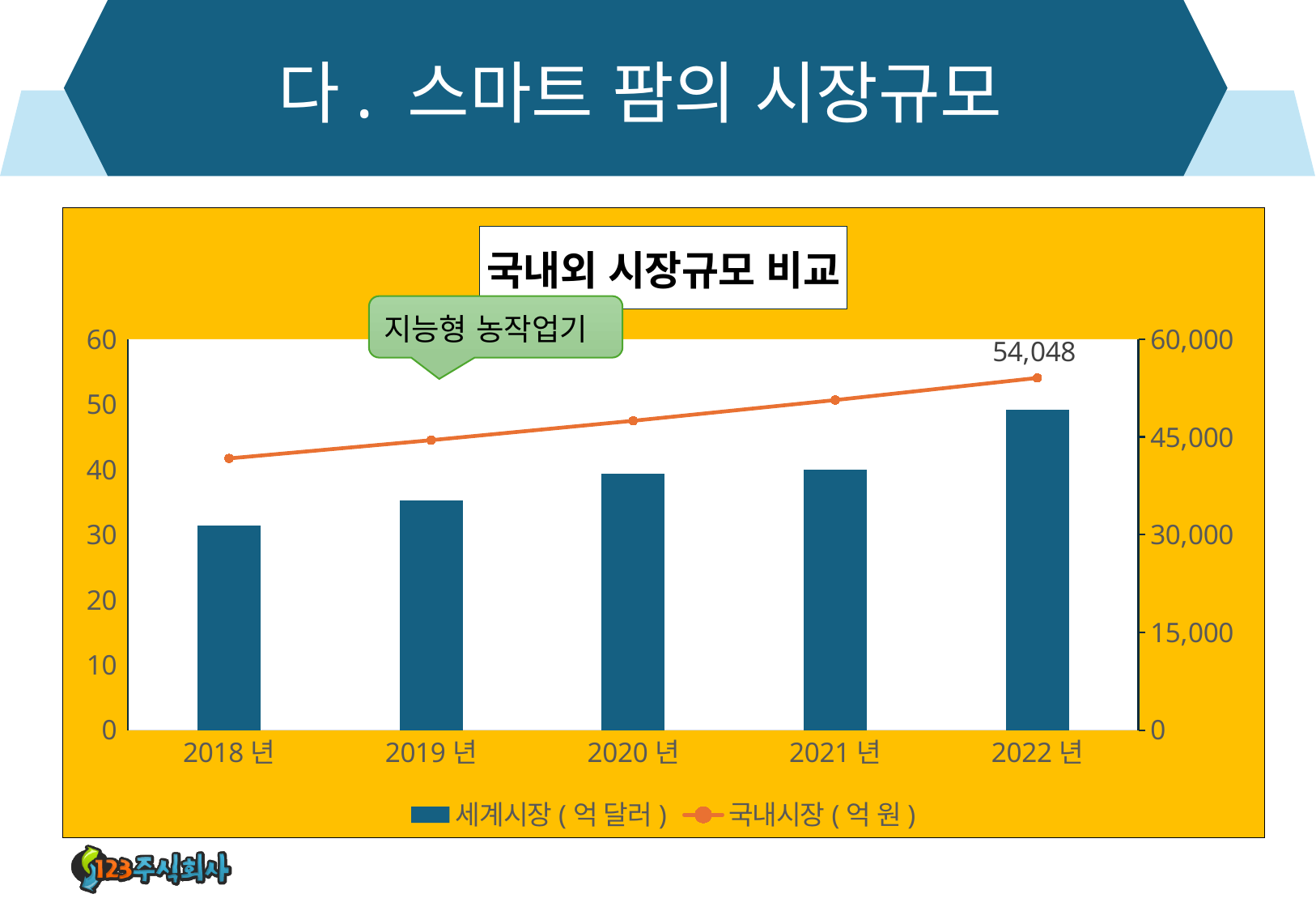
Does the 국내시장 ( 억 원 ) line rise or fall from 2018 년 to 2022 년? Rises Is the 세계시장 ( 억 달러 ) value for 2022 년 greater or less than 40? greater Which year has the larger 세계시장 ( 억 달러 ) value, 2018 년 or 2022 년? 2022 년 What is the value of 국내시장 ( 억 원 ) for 2022 년? 54,048 In which year is the 세계시장 ( 억 달러 ) bar the highest? 2022 년 Is the 국내시장 ( 억 원 ) value for 2018 년 greater or less than 30,000? greater How many series does the legend list? 2 How many years are shown on the x axis of the chart? 5 In which year is the 세계시장 ( 억 달러 ) bar the lowest? 2018 년 What is the title of the chart? 국내외 시장규모 비교 What kind of chart is shown on the slide? A combined bar and line chart Is the 세계시장 ( 억 달러 ) value for 2018 년 greater or less than 40? less